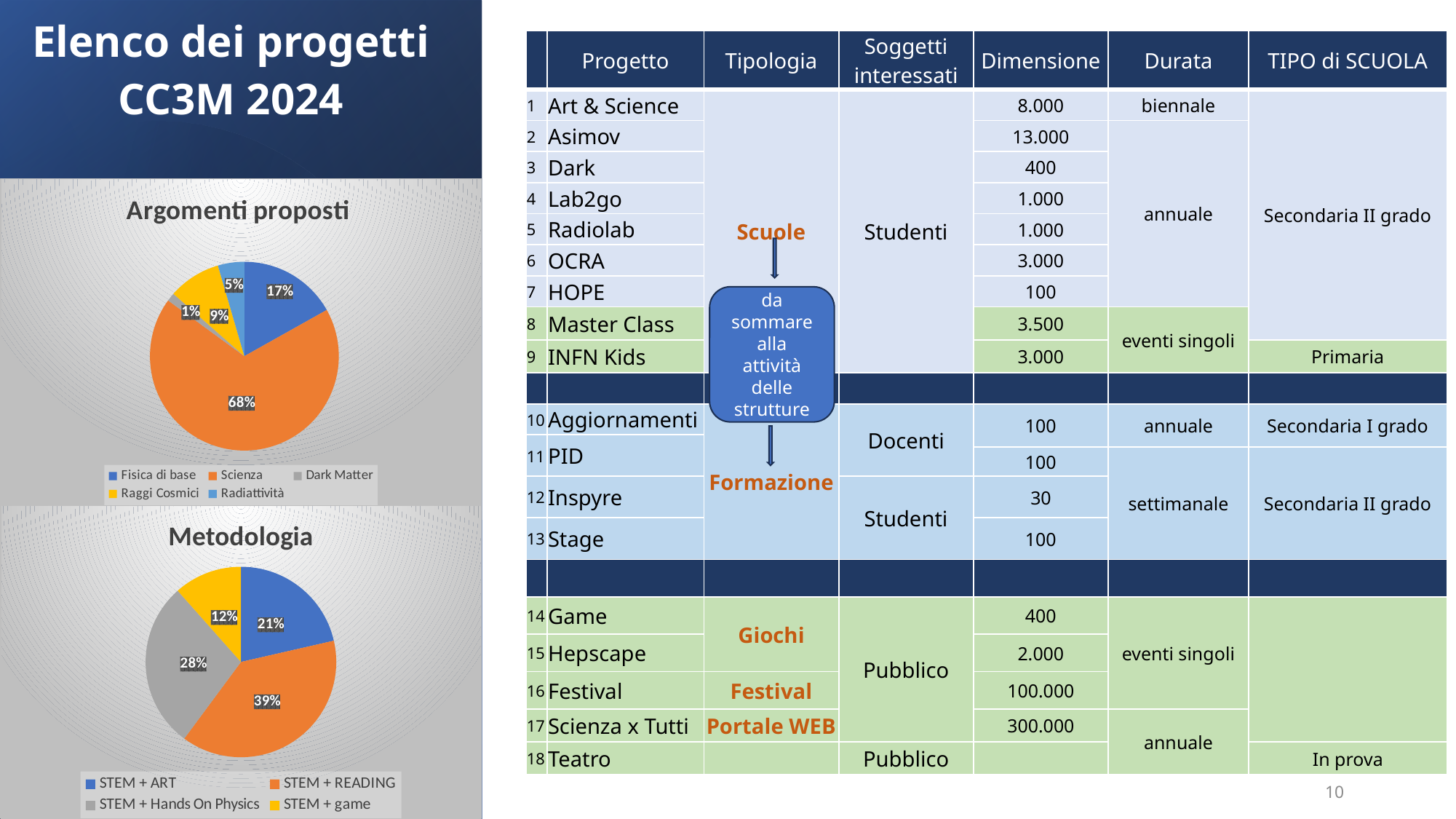
In the 'Metodologia' chart, which category has the smallest share? STEM + game In the 'Argomenti proposti' chart, which category has the largest share? Scienza In the 'Metodologia' chart, what share does STEM + Hands On Physics have? 28% In the 'Argomenti proposti' chart, how many categories does the legend list? 5 What kind of chart is the 'Metodologia' chart? pie chart In the 'Metodologia' chart, what is the difference between the shares of STEM + READING and STEM + ART? 18% In the 'Metodologia' chart, which is larger: STEM + ART or STEM + game? STEM + ART In the 'Argomenti proposti' chart, what share does Scienza have? 68% In the 'Argomenti proposti' chart, what is the difference between the shares of Raggi Cosmici and Radiattività? 4% In the 'Argomenti proposti' chart, what share does Fisica di base have? 17% In the 'Metodologia' chart, what share does STEM + READING have? 39% In the 'Argomenti proposti' chart, which category has the smallest share? Dark Matter